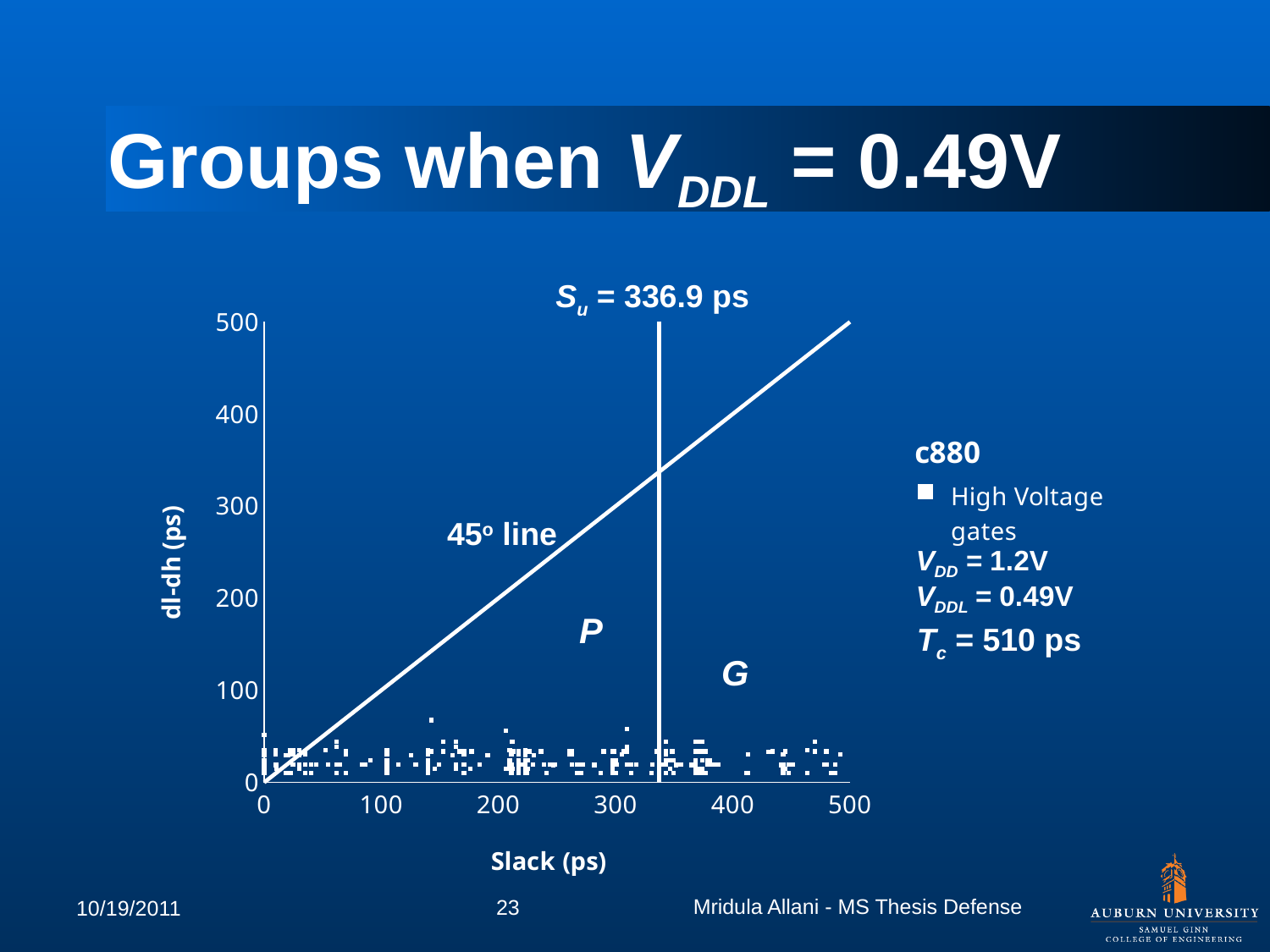
What series name is listed in the chart's legend? High Voltage gates What is the value of T_c stated next to the chart? 510 ps What is the title of the chart? c880 What kind of chart is shown on the slide? scatter chart What is the label of the y axis of the chart? dl-dh (ps) What value of S_u is annotated above the vertical line in the chart? 336.9 ps What is the label of the x axis of the chart? Slack (ps) What is the highest tick value shown on the x axis of the chart? 500 How many series does the legend of the chart list? 1 Are the dl-dh values of the plotted points greater or less than 100? less